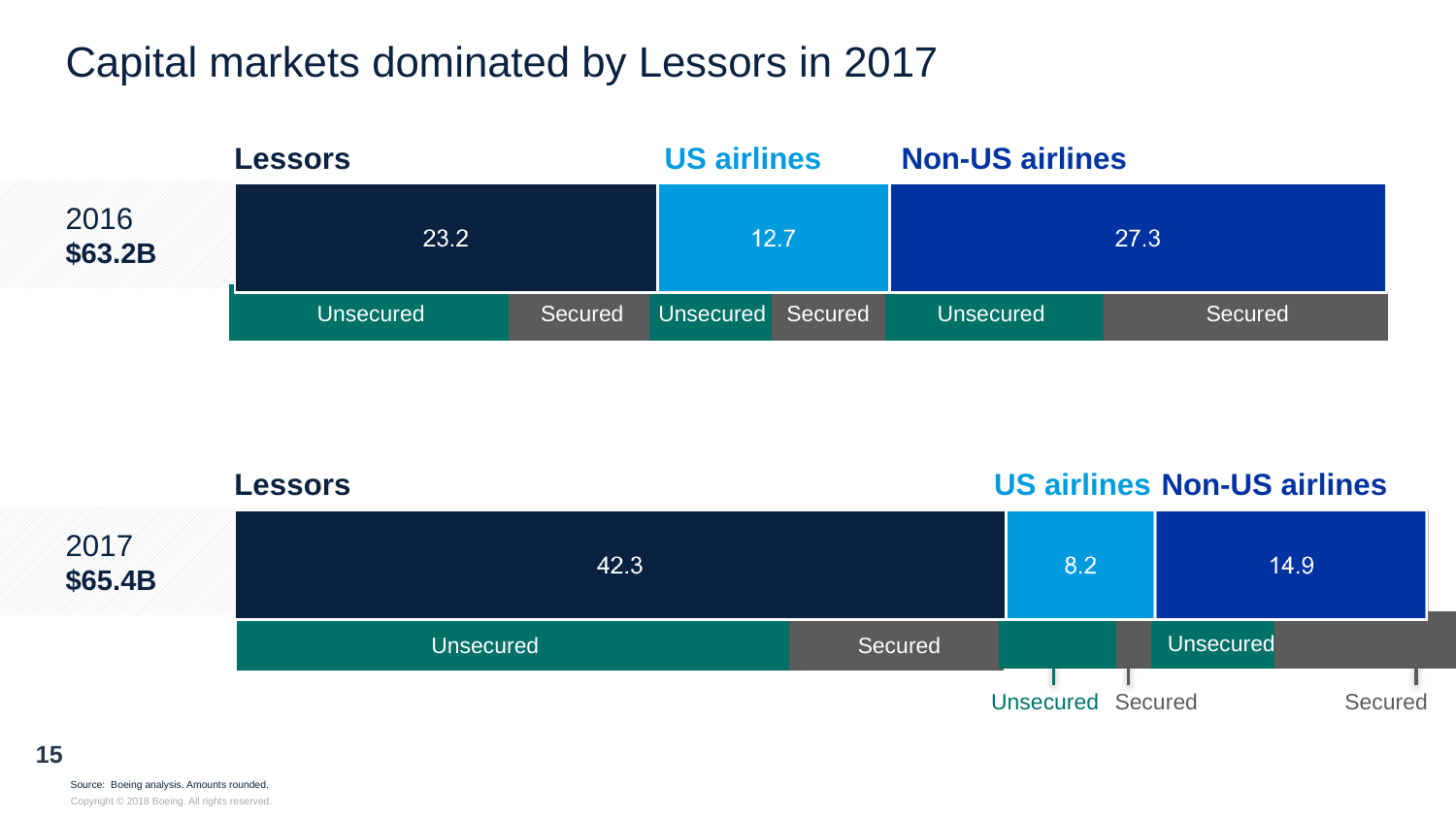
In the 2017 bar, what is the value for Non-US airlines? 14.9 What is the total shown for the 2017 bar? $65.4B In the 2017 bar, which segment is the largest? Lessors In the 2016 bar, what is the value for US airlines? 12.7 In the 2016 bar, which segment is the largest? Non-US airlines What kind of chart is shown on the slide? Stacked bar chart In the 2017 bar, is the value for US airlines or Non-US airlines larger? Non-US airlines What is the total shown for the 2016 bar? $63.2B What is the difference between the Lessors value in 2017 and the Lessors value in 2016? 19.1 In the 2016 bar, which segment is the smallest? US airlines How many segments make up each year's bar? 3 In the 2016 bar, what is the value for Lessors? 23.2